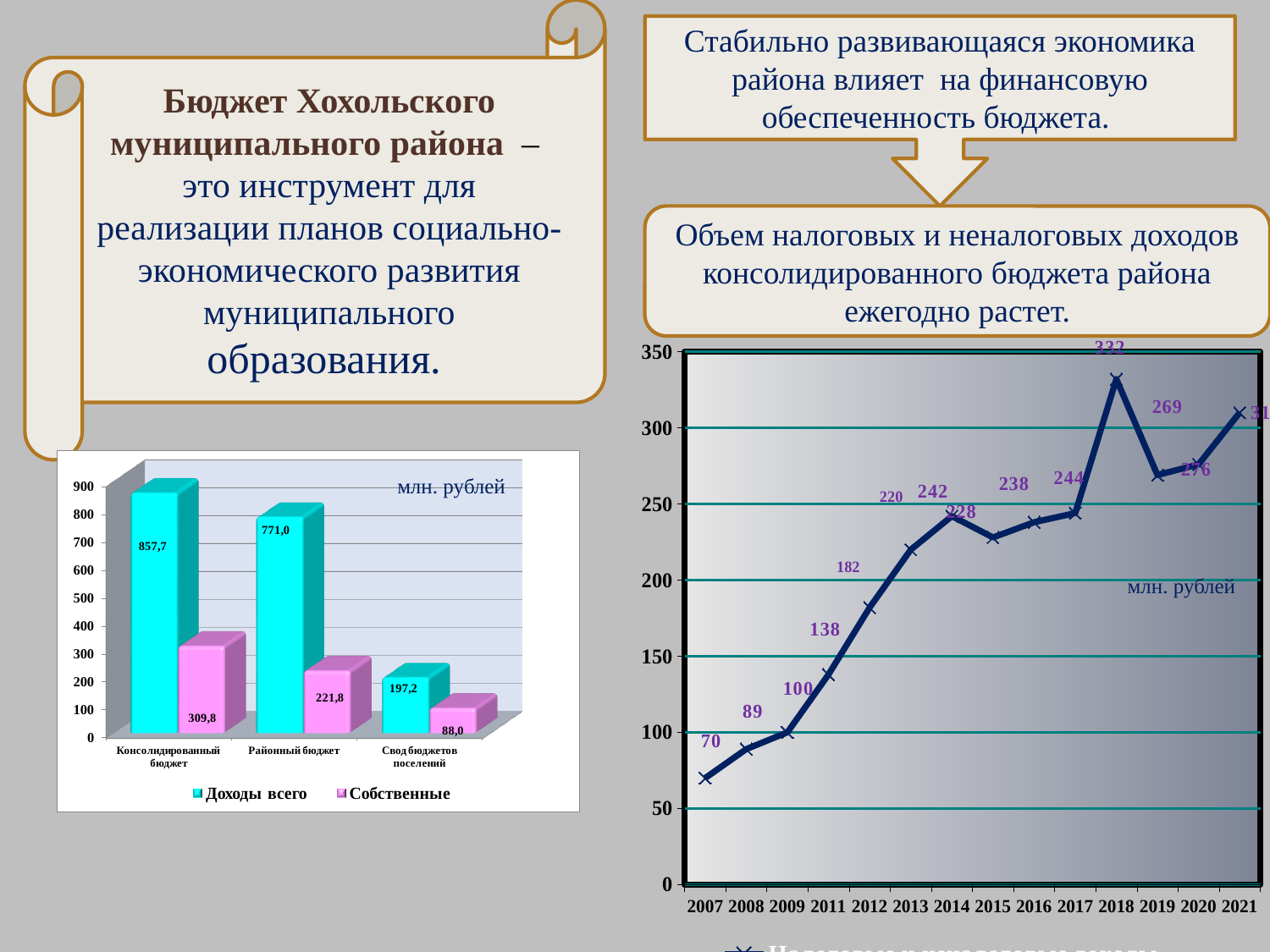
In the line chart on the right, which is larger, the value for 2014 or the value for 2015? 2014 In the line chart on the right, what is the difference between the values for 2018 and 2017? 88 In the line chart on the right, which year has the highest value? 2018 In the line chart on the right, how many years are plotted on the x axis? 14 In the bar chart on the left, what is the difference between Доходы всего and Собственные for Консолидированный бюджет? 547,9 In the bar chart on the left, what is the value of Собственные for Свод бюджетов поселений? 88,0 In the line chart on the right, what is the value for 2007? 70 In the line chart on the right, what is the value for 2018? 332 What kind of chart is the chart on the left of the slide? bar chart In the bar chart on the left, what is the value of Собственные for Районный бюджет? 221,8 In the bar chart on the left, how many series does the legend list? 2 In the bar chart on the left, what is the value of Доходы всего for Консолидированный бюджет? 857,7